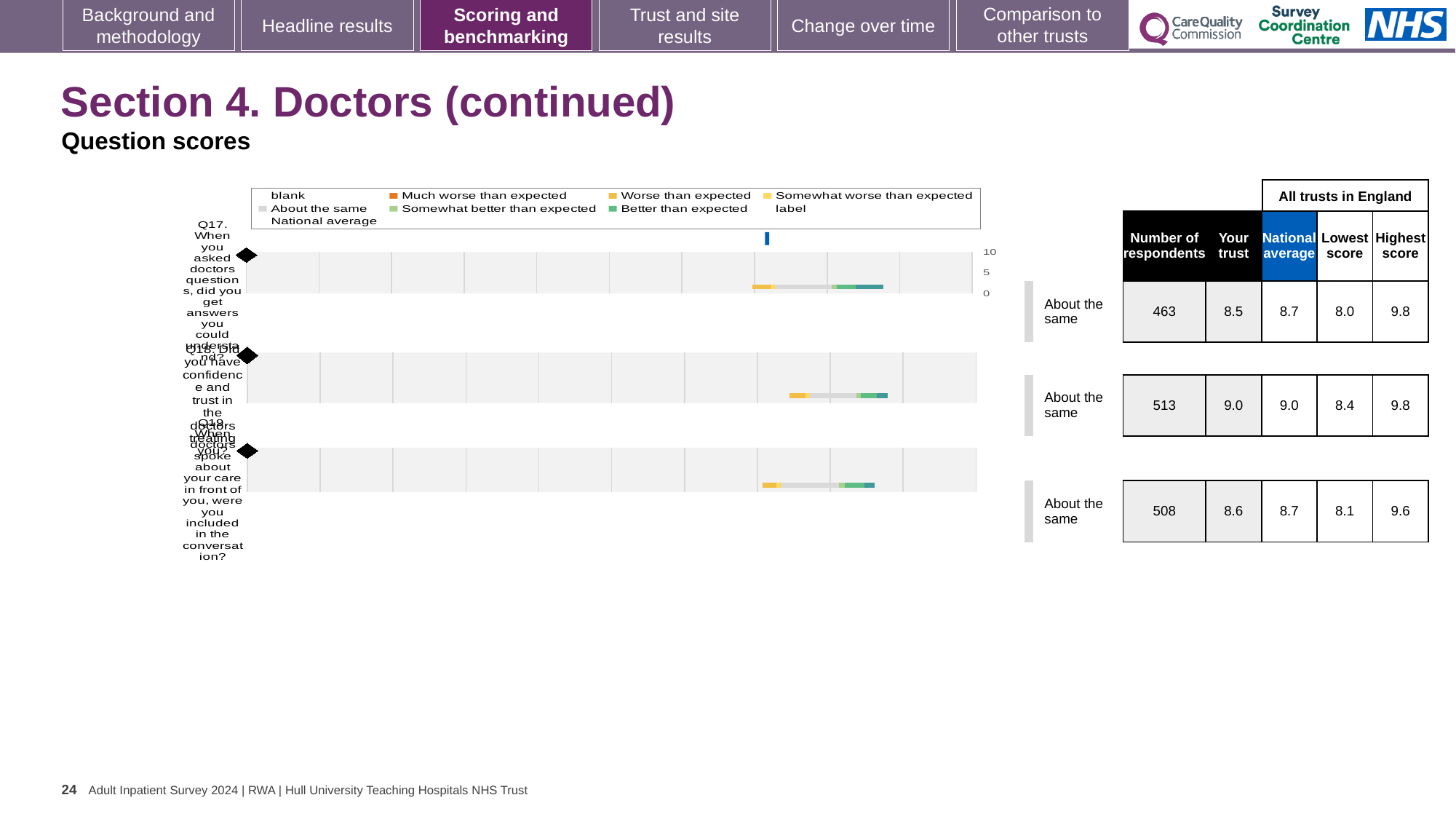
For Q17, what is the 'Your trust' score? 8.5 For Q18 (Did you have confidence and trust in the doctors treating you?), what is the national average score? 9.0 What kind of chart is used for the question scores on this slide? bar chart Which question has the highest 'Your trust' score? Q18 Which has the larger 'Your trust' score, Q18 or Q19? Q18 For Q17 (When you asked doctors questions, did you get answers you could understand?), what is the number of respondents? 463 How many questions (Q17, Q18, Q19) are charted on this slide? 3 For Q19 (When doctors spoke about your care in front of you, were you included in the conversation?), what is the highest score among all trusts in England? 9.6 For Q17, what is the difference between the national average and the 'Your trust' score? 0.2 Which question has the lowest 'Lowest score' among all trusts in England? Q17 What benchmark category is shown for Q18? About the same What is the maximum value shown on the score axis of the charts? 10